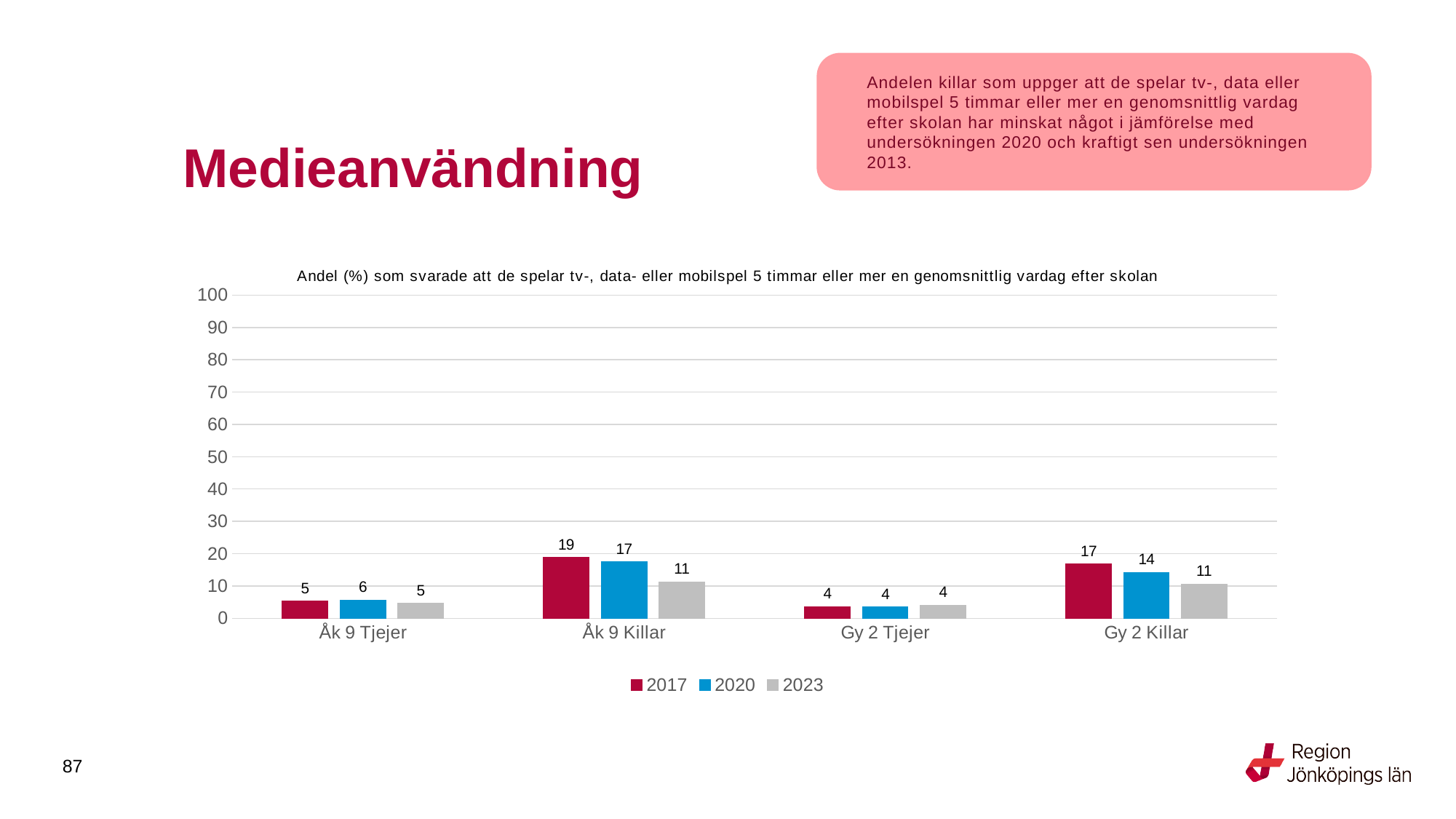
What kind of chart is shown on the slide? bar chart Which category has the highest value in the 2017 series? Åk 9 Killar What is the difference between the 2017 and 2023 values for Åk 9 Killar? 8 Which category has the lowest value in the 2020 series? Gy 2 Tjejer What is the value for Åk 9 Killar in the 2017 series? 19 How many categories are shown on the x axis? 4 Do the values for Gy 2 Killar rise or fall from 2017 to 2023? fall Which is larger for Gy 2 Killar: the 2017 value or the 2023 value? 2017 What is the value for Gy 2 Killar in the 2020 series? 14 How many series does the legend list? 3 What is the value for Åk 9 Tjejer in the 2023 series? 5 Is the value for Åk 9 Killar in 2017 greater or less than 10? greater